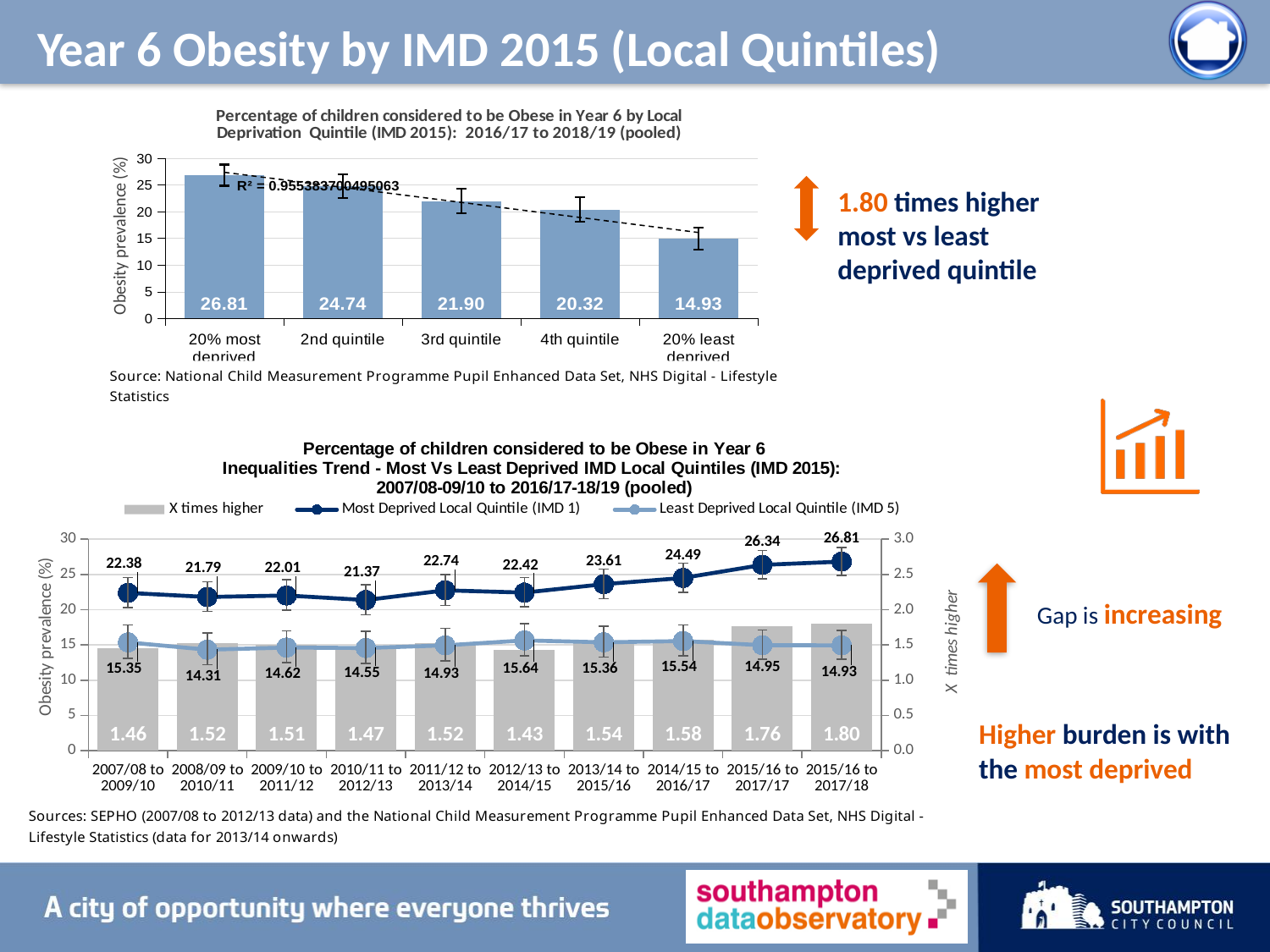
In the top chart, what is the obesity prevalence for the 20% most deprived quintile? 26.81 In the bottom chart, is the Most Deprived Local Quintile (IMD 1) value for 2015/16 to 2017/17 larger or smaller than the value for 2014/15 to 2016/17? larger In the bottom chart, what is the 'X times higher' value for 2015/16 to 2017/18? 1.80 In the top chart, which quintile has the lowest obesity prevalence? 20% least deprived In the bottom chart, which period has the lowest 'X times higher' value? 2012/13 to 2014/15 In the top chart, what is the difference in obesity prevalence between the 20% most deprived and the 20% least deprived quintiles? 11.88 In the top chart, how many quintile categories are plotted? 5 In the top chart, what is the obesity prevalence for the 3rd quintile? 21.90 In the bottom chart, what is the Least Deprived Local Quintile (IMD 5) value for 2012/13 to 2014/15? 15.64 In the top chart, do the values rise or fall from the most deprived to the least deprived quintile? fall In the bottom chart, how many series does the legend list? 3 In the bottom chart, what is the Most Deprived Local Quintile (IMD 1) value for 2007/08 to 2009/10? 22.38